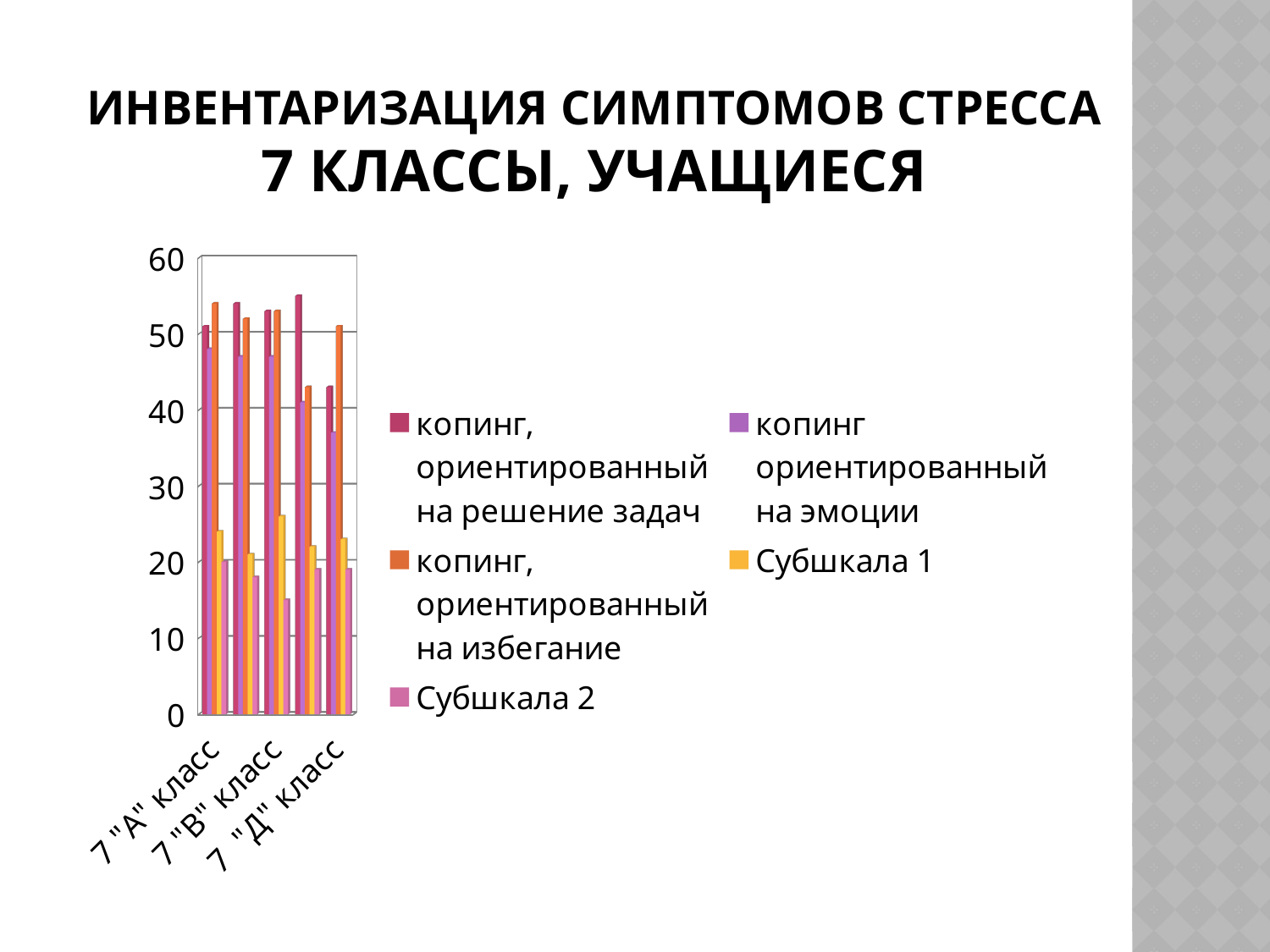
What is the first entry in the chart's legend? копинг, ориентированный на решение задач How many series does the legend list? 5 In the leftmost group of bars, is the value for Субшкала 1 greater or less than 30? less Is the tallest bar in the chart greater or less than 60? less In the rightmost group of bars, is the value for "копинг ориентированный на эмоции" greater or less than 40? less In the leftmost group of bars, which is larger, Субшкала 1 or Субшкала 2? Субшкала 1 What kind of chart is shown on the slide? bar chart What colour represents the series "копинг ориентированный на эмоции"? purple